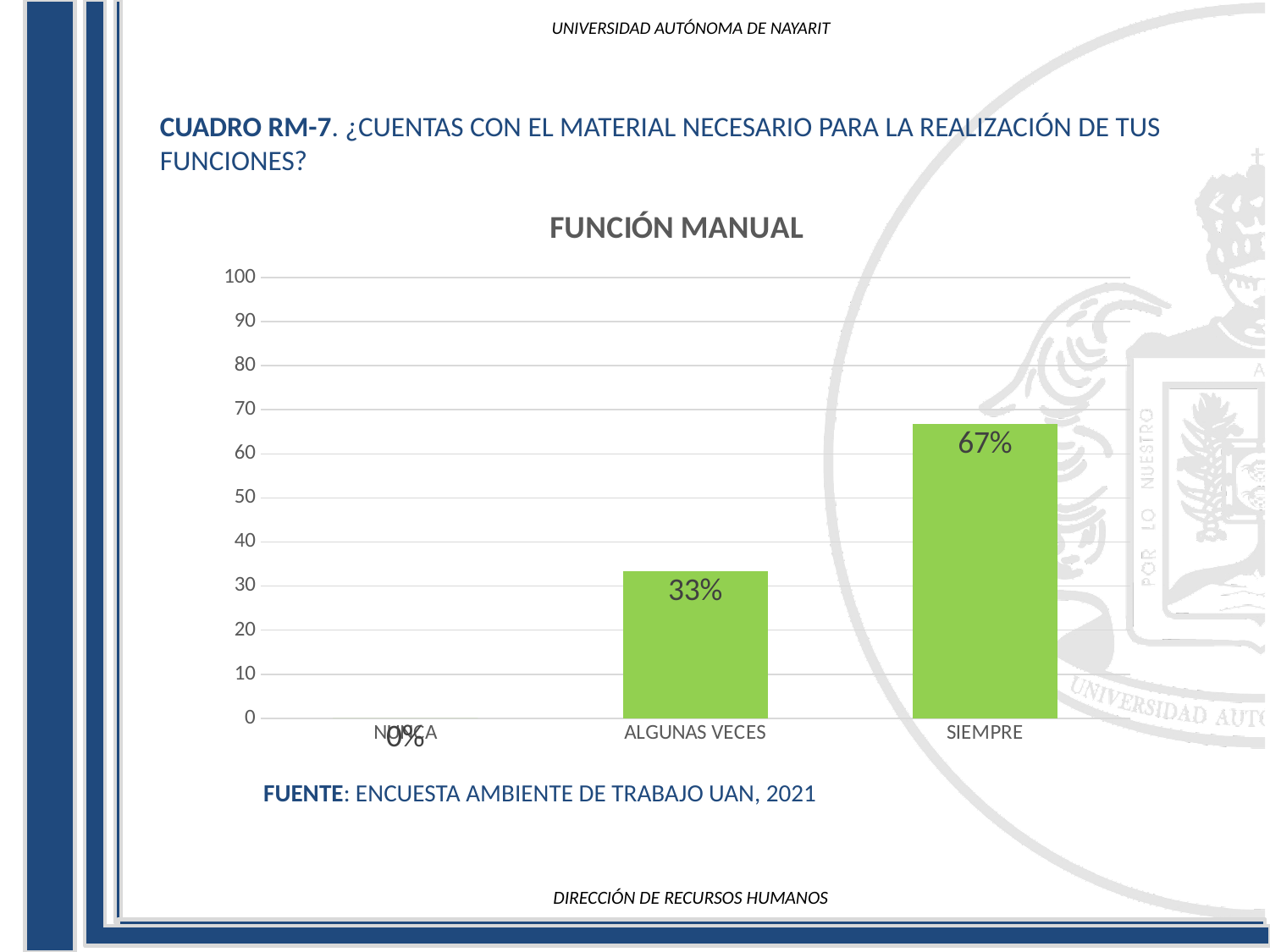
What is the value for ALGUNAS VECES? 33% Which category has the highest value? SIEMPRE Is the value for ALGUNAS VECES greater or less than 40? less Which category has the lowest value? NUNCA What is the difference between the values for SIEMPRE and ALGUNAS VECES? 34% Which is larger, the value for ALGUNAS VECES or the value for SIEMPRE? SIEMPRE What kind of chart is shown? bar chart What is the title of the chart? FUNCIÓN MANUAL What is the value for NUNCA? 0% What is the value for SIEMPRE? 67% How many categories are shown on the x axis? 3 Is the value for SIEMPRE greater or less than 50? greater